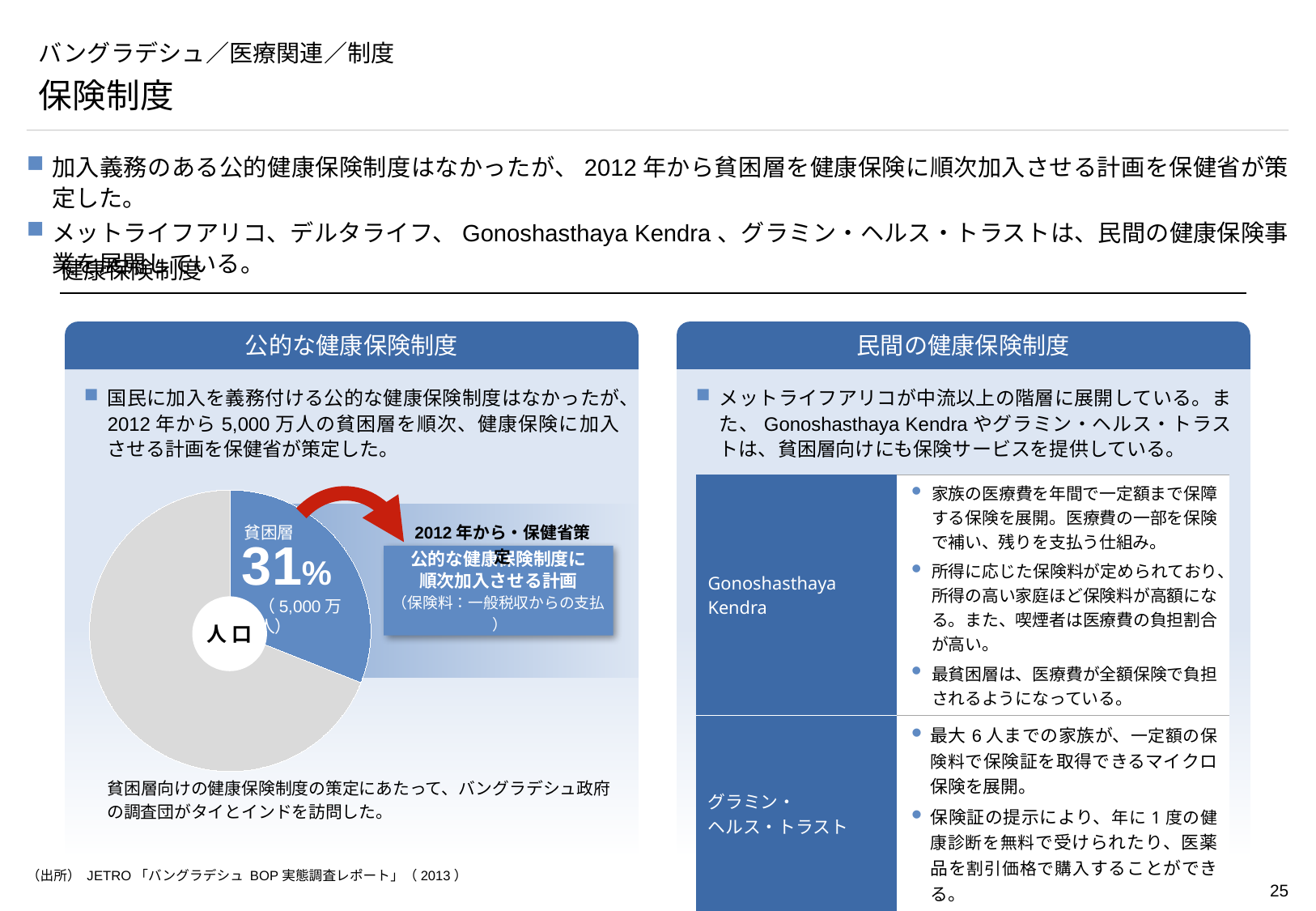
How many people does the 貧困層 slice of the pie chart correspond to, as printed on the chart? 5,000万人 What label is printed in the centre of the pie chart? 人口 Is the share of the 貧困層 slice in the pie chart greater or less than 50%? less Which slice of the pie chart is larger, the 貧困層 slice or the unlabeled grey slice? the unlabeled grey slice How many slices does the pie chart have? 2 What share of the pie chart is taken by the portion that is not 貧困層? 69% What colour is the 貧困層 slice in the pie chart? blue What share of 人口 does the 貧困層 slice represent in the pie chart? 31% What kind of chart is shown under 公的な健康保険制度? pie chart